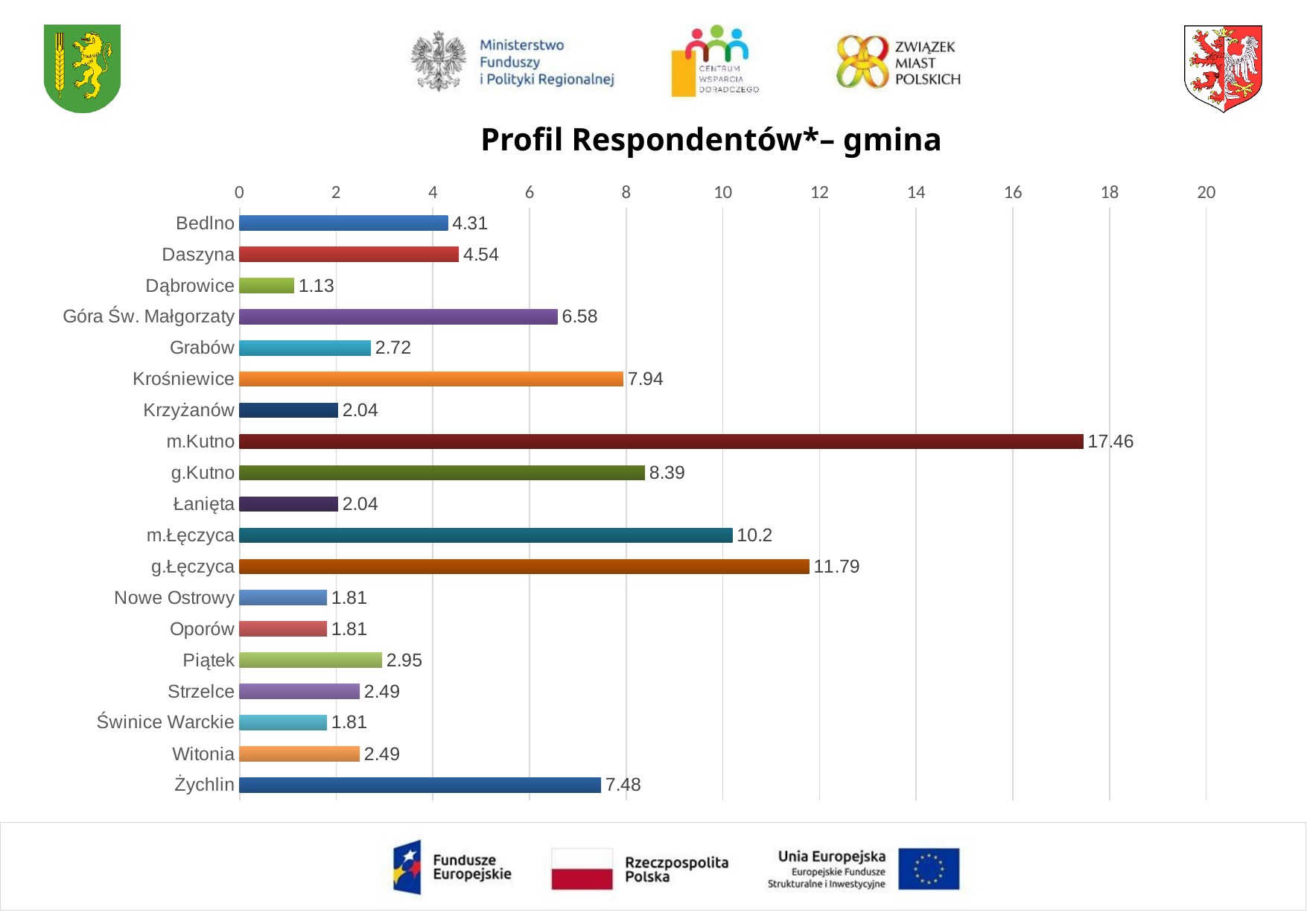
What kind of chart is shown on the slide? bar chart What is the difference between the values for m.Kutno and g.Kutno? 9.07 What is the value for m.Kutno? 17.46 Is the value for g.Łęczyca greater or less than 10? greater What is the value for Krośniewice? 7.94 What is the title of the chart? Profil Respondentów*– gmina What is the difference between the values for g.Łęczyca and m.Łęczyca? 1.59 What is the value for Góra Św. Małgorzaty? 6.58 How many gminas are shown on the chart? 19 Which gmina has the lowest value? Dąbrowice Which gmina has the highest value? m.Kutno Which is larger, the value for Żychlin or the value for Krośniewice? Krośniewice